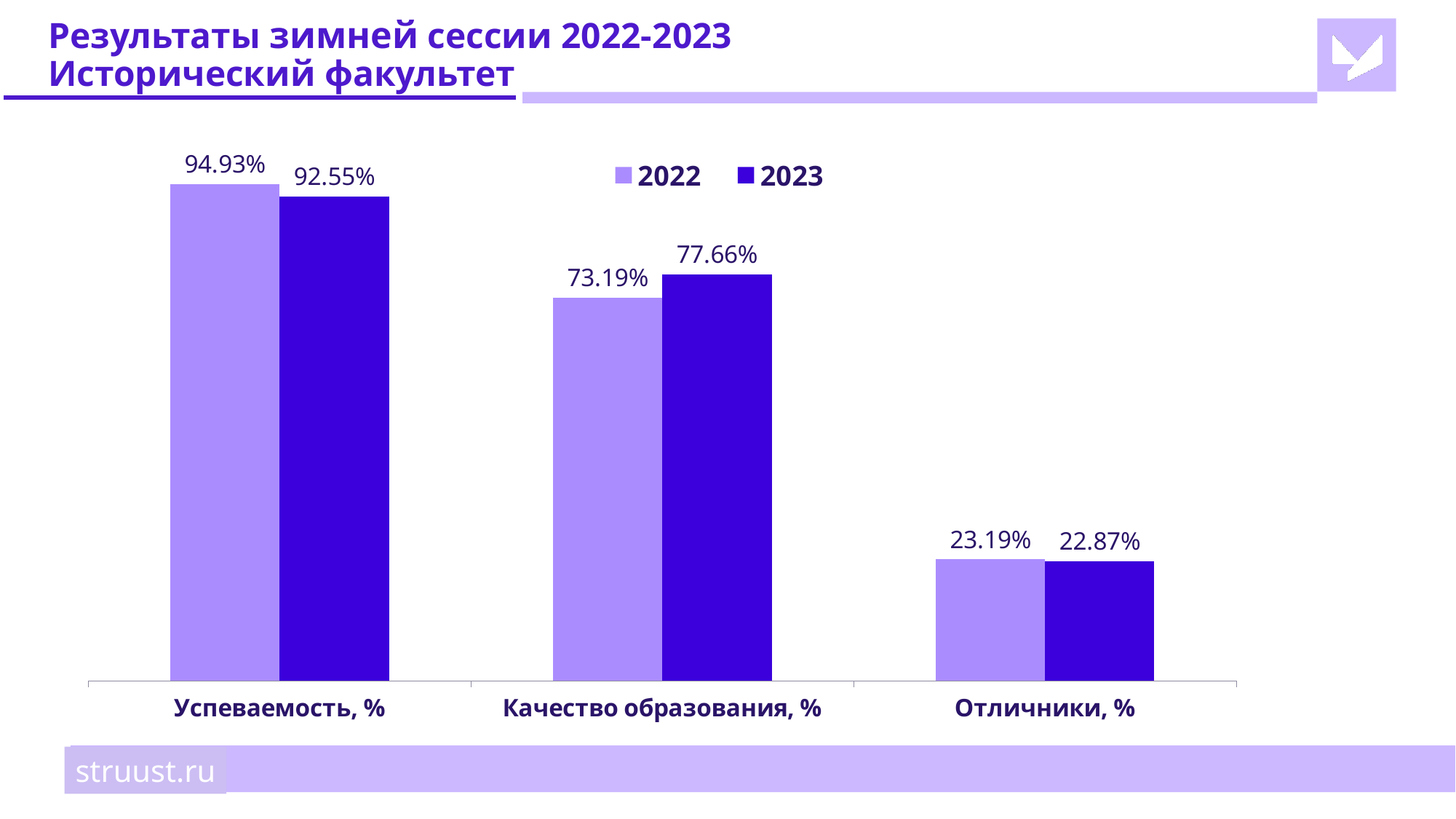
What is the value for Успеваемость, % in 2022? 94.93% What is the value for Отличники, % in 2022? 23.19% What is the value for Успеваемость, % in 2023? 92.55% How many categories are shown on the x axis? 3 Which category has the highest value in 2022? Успеваемость, % For Качество образования, %, which year has the larger value, 2022 or 2023? 2023 What is the difference between the 2023 and 2022 values for Качество образования, %? 4.47% How many series does the legend list? 2 What is the value for Качество образования, % in 2023? 77.66% What is the difference between the 2022 and 2023 values for Успеваемость, %? 2.38% What kind of chart is shown on the slide? Bar chart Which category has the lowest value in 2023? Отличники, %